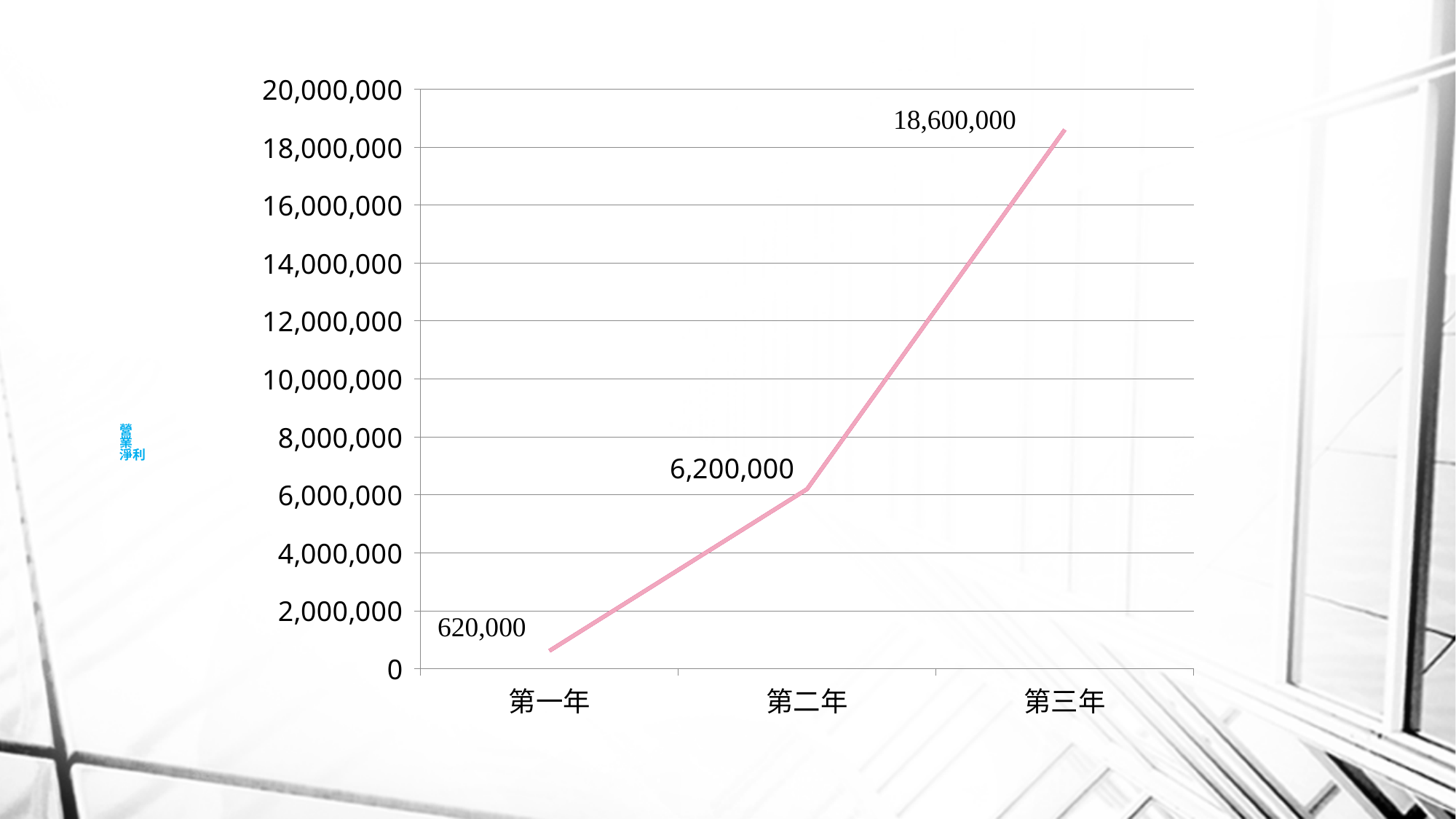
What is the difference between the values for 第二年 and 第一年? 5,580,000 What is the value for 第二年? 6,200,000 Do the values rise or fall from 第一年 to 第三年? rise Which year has the lowest value? 第一年 What is the difference between the values for 第三年 and 第二年? 12,400,000 Which is larger, the value for 第二年 or the value for 第一年? 第二年 Is the value for 第三年 greater or less than 16,000,000? greater What kind of chart is shown on the slide? line chart Which year has the highest value? 第三年 How many years are plotted on the x axis? 3 What is the value for 第三年? 18,600,000 What is the value for 第一年? 620,000